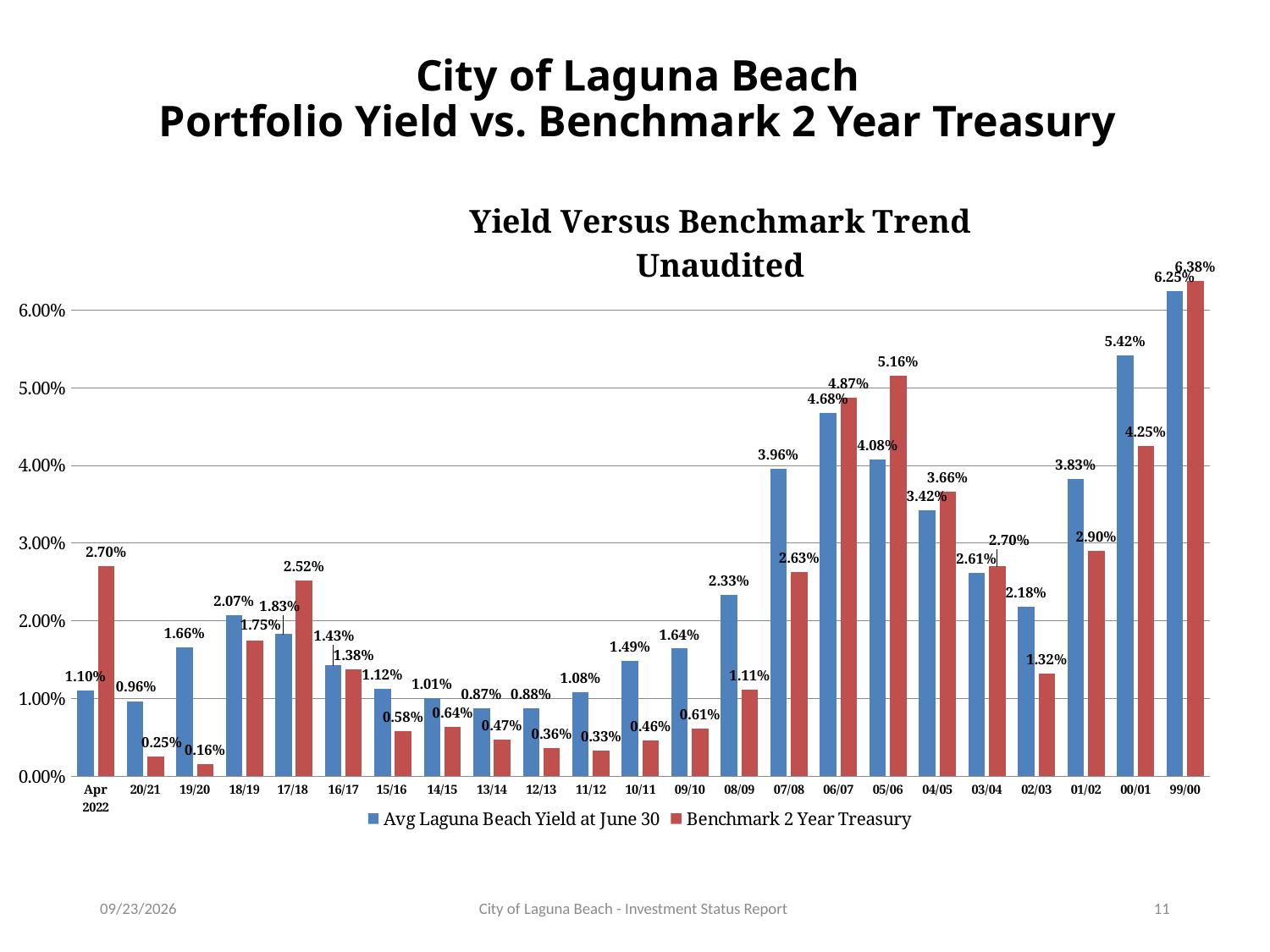
What is the title of the chart? Yield Versus Benchmark Trend Unaudited Is the Avg Laguna Beach Yield at June 30 for 06/07 greater or less than 4.00%? greater How many series does the legend list? 2 How many periods are shown on the x axis? 23 Which period has the lowest Benchmark 2 Year Treasury value? 19/20 What kind of chart is shown on the slide? Bar chart For 00/01, which is larger: the Avg Laguna Beach Yield at June 30 or the Benchmark 2 Year Treasury? Avg Laguna Beach Yield at June 30 Which period has the highest Avg Laguna Beach Yield at June 30? 99/00 What is the difference between the Avg Laguna Beach Yield at June 30 and the Benchmark 2 Year Treasury for 20/21? 0.71% What is the Benchmark 2 Year Treasury value for Apr 2022? 2.70% What is the Avg Laguna Beach Yield at June 30 for 07/08? 3.96% What is the Benchmark 2 Year Treasury value for 05/06? 5.16%